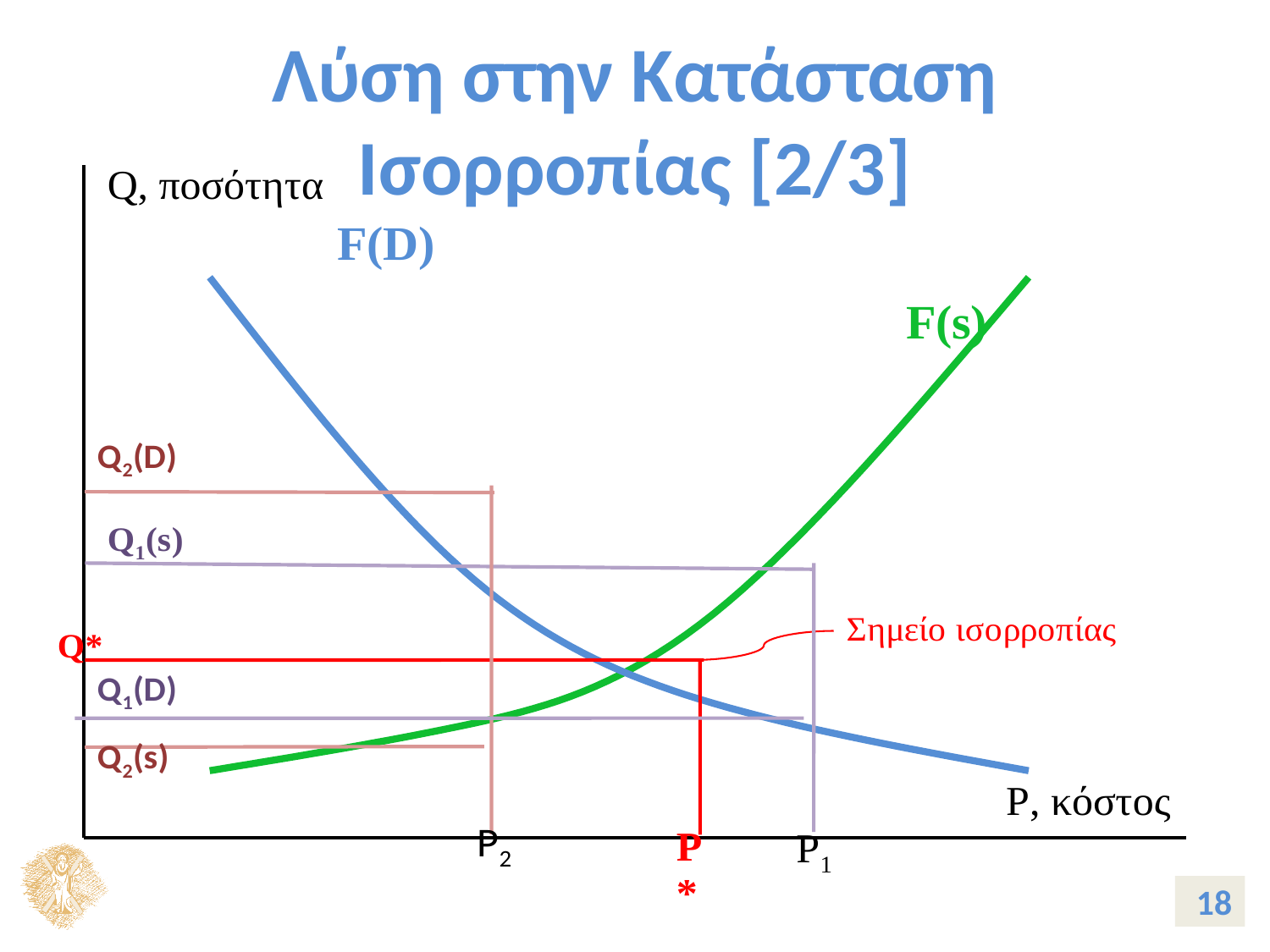
Which of the two curves, F(D) or F(s), has the higher value at the right end of the chart? F(s) What kind of chart is shown on the slide? line chart Does the F(D) curve rise or fall as P increases along the x axis? fall What is the label of the point where the F(D) and F(s) curves intersect? Σημείο ισορροπίας Which of the two curves, F(D) or F(s), has the higher value at the left end of the chart? F(D) How many curves are plotted on the chart? 2 Which is larger on the y axis, Q2(D) or Q1(s)? Q2(D) What is the label of the horizontal axis? P, κόστος Does the F(s) curve rise or fall as P increases along the x axis? rise